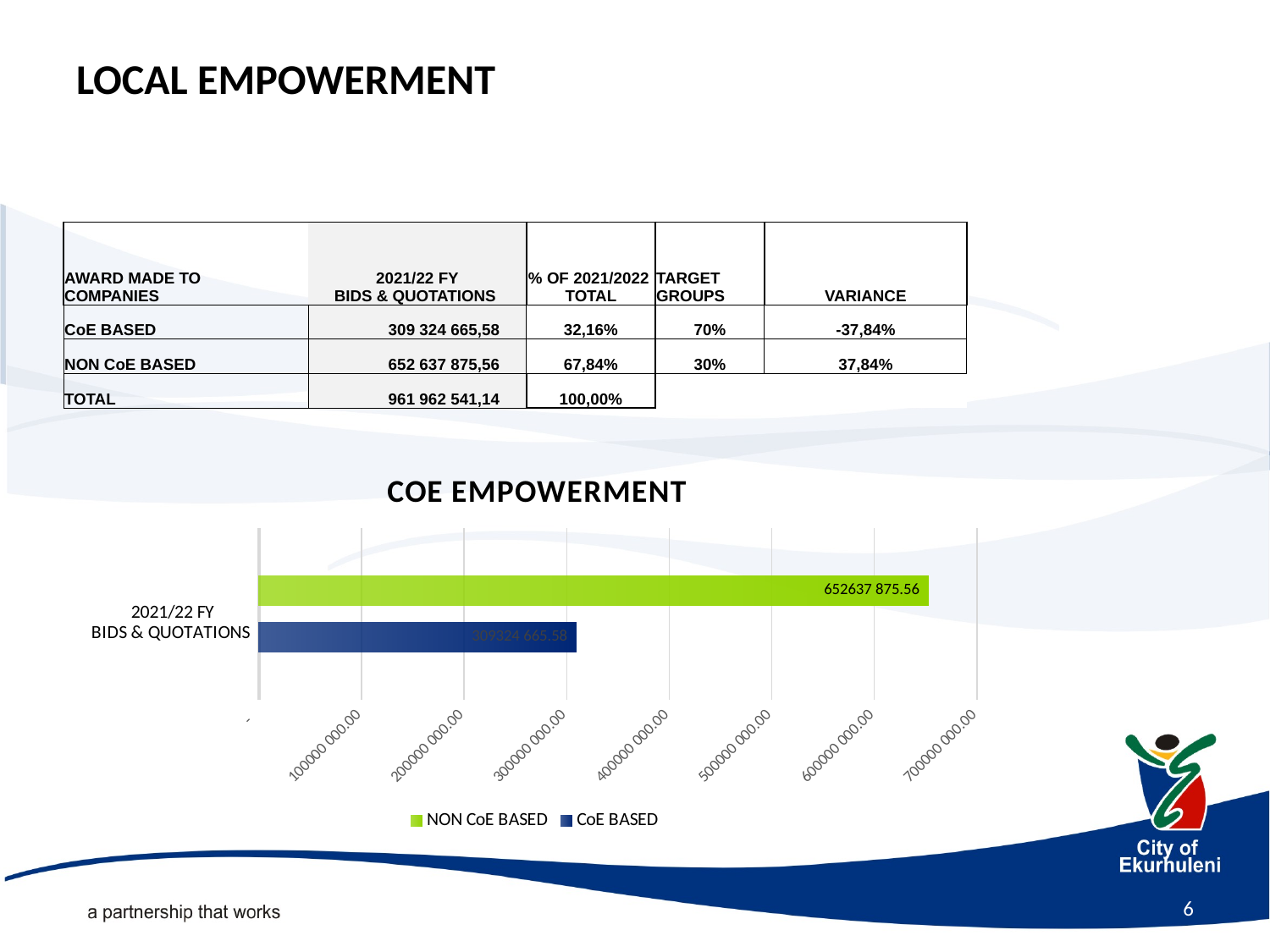
In the COE EMPOWERMENT chart, what colour is the NON CoE BASED bar? green In the COE EMPOWERMENT chart, is the value for CoE BASED greater or less than 400000 000.00? less How many series does the legend of the COE EMPOWERMENT chart list? 2 What is the title of the chart on the slide? COE EMPOWERMENT In the COE EMPOWERMENT chart, which series has the shorter bar? CoE BASED What type of chart is shown under the title COE EMPOWERMENT? bar chart How many categories are shown on the vertical axis of the COE EMPOWERMENT chart? 1 In the COE EMPOWERMENT chart, what is the value shown for NON CoE BASED? 652637 875.56 In the COE EMPOWERMENT chart, is the value for CoE BASED greater or less than 200000 000.00? greater In the COE EMPOWERMENT chart, is the value for NON CoE BASED greater or less than 600000 000.00? greater In the COE EMPOWERMENT chart, which series has the longer bar? NON CoE BASED In the COE EMPOWERMENT chart, is the value for NON CoE BASED larger or smaller than the value for CoE BASED? larger